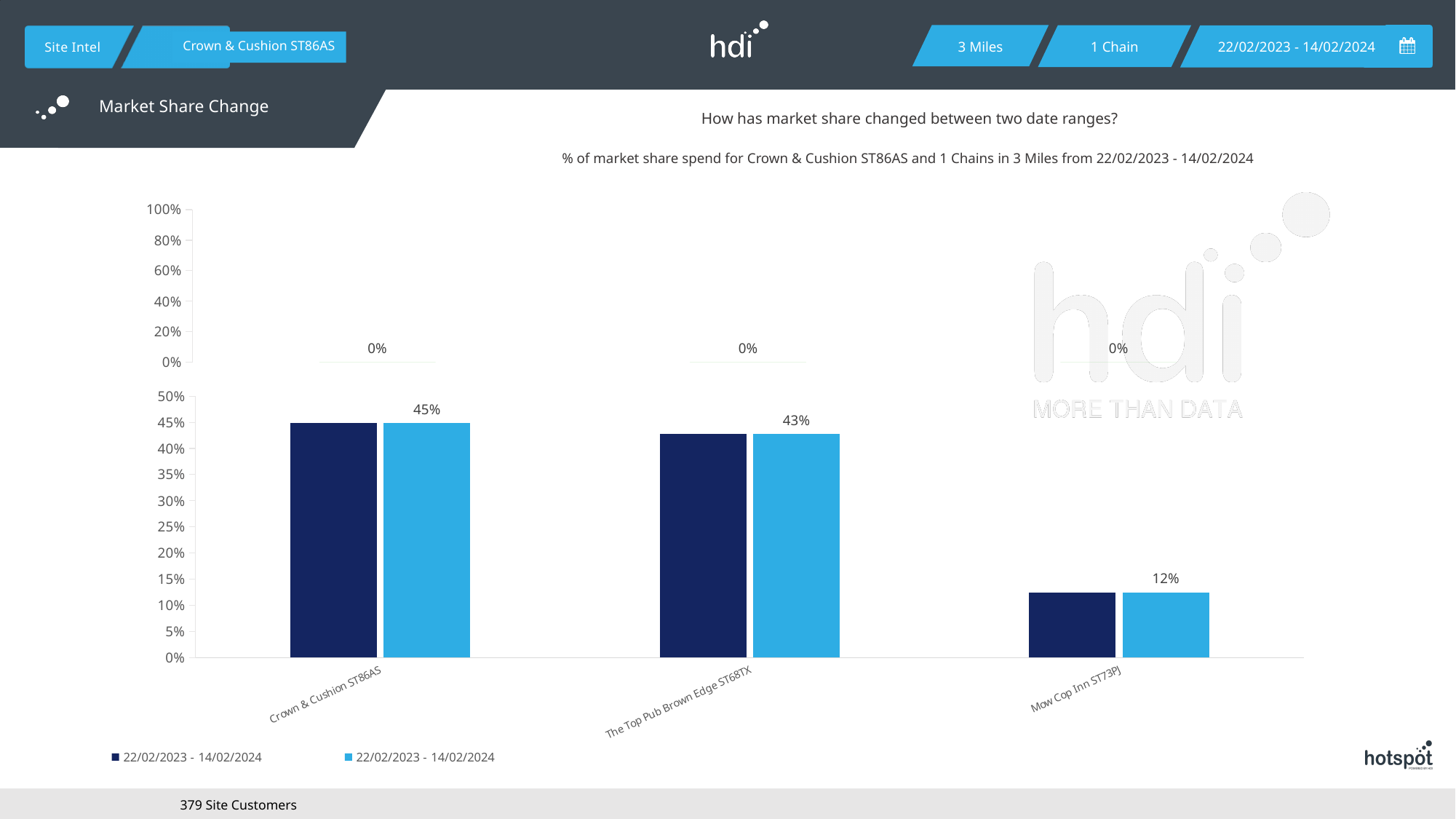
In the bottom chart, is the labelled value for The Top Pub Brown Edge ST68TX larger or smaller than the value for Mow Cop Inn ST73PJ? larger In the bottom chart, what is the difference between the labelled values for Crown & Cushion ST86AS and Mow Cop Inn ST73PJ? 33% What kind of chart is the bottom chart? bar chart In the top chart, what change value is labelled for Crown & Cushion ST86AS? 0% In the bottom chart, which category has the highest market share? Crown & Cushion ST86AS In the bottom chart, what is the market share value labelled for The Top Pub Brown Edge ST68TX? 43% In the bottom chart, what is the market share value labelled for Mow Cop Inn ST73PJ? 12% In the bottom chart, is the dark blue bar for Mow Cop Inn ST73PJ greater or less than 20%? less In the bottom chart, which category has the lowest market share? Mow Cop Inn ST73PJ How many series does the legend of the bottom chart list? 2 In the bottom chart, what is the market share value labelled for Crown & Cushion ST86AS? 45% How many categories are shown on the x axis of the bottom chart? 3